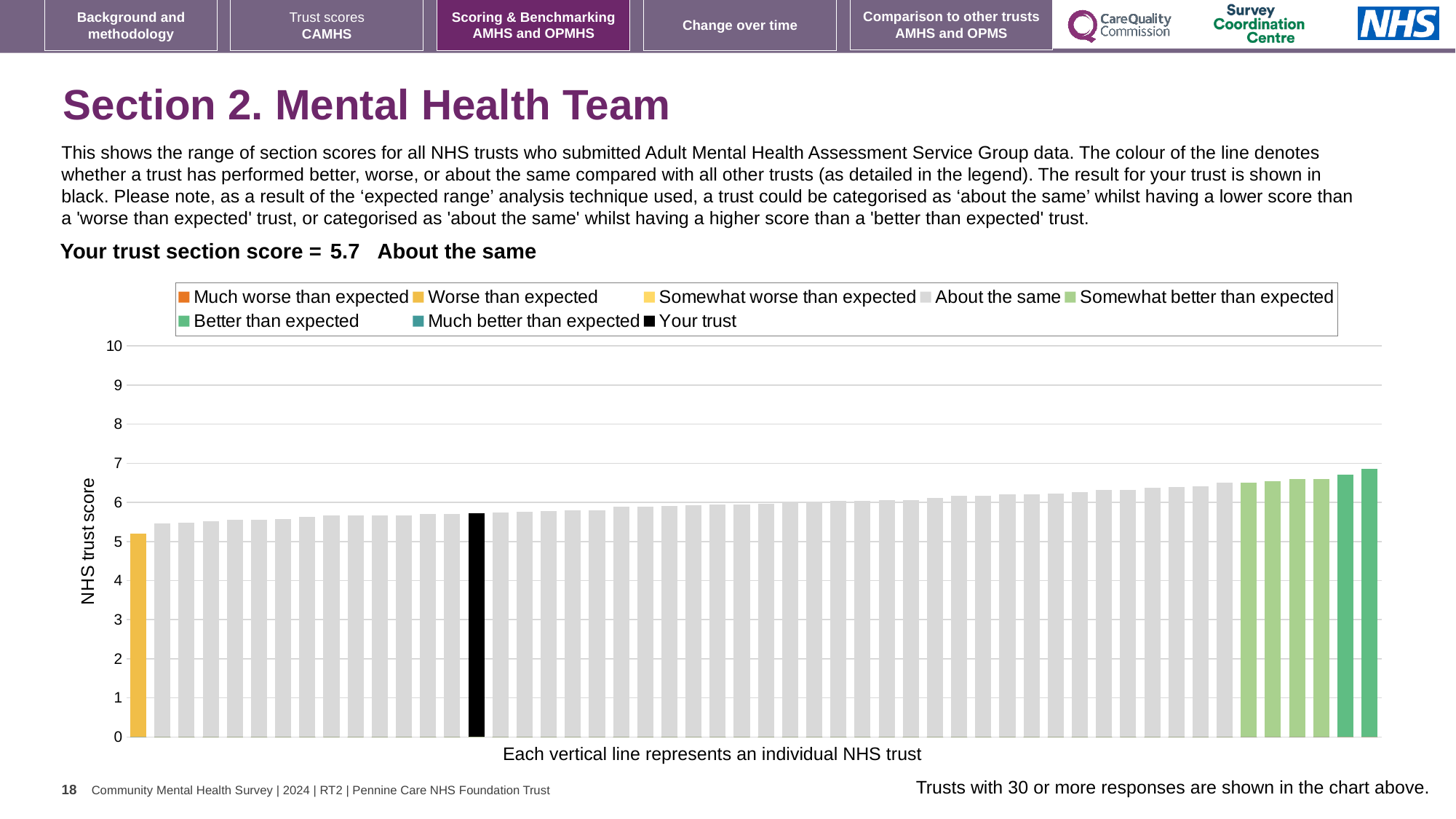
How many entries does the chart legend list? 8 What kind of chart is shown on the slide? bar chart Do the bar values rise or fall from left to right along the x axis? rise How many bars are coloured as 'Better than expected'? 2 Which performance category is your trust placed in? About the same Is the value of the highest bar on the chart greater or less than 7? less Is the value of the lowest bar (the yellow 'Worse than expected' bar) greater or less than 6? less What is the section score for your trust shown on the slide? 5.7 Which legend category does the tallest bar on the chart belong to? Better than expected How many bars are coloured as 'Somewhat better than expected'? 4 What is the label on the vertical axis of the chart? NHS trust score Is the value of the black 'Your trust' bar greater or less than 5? greater